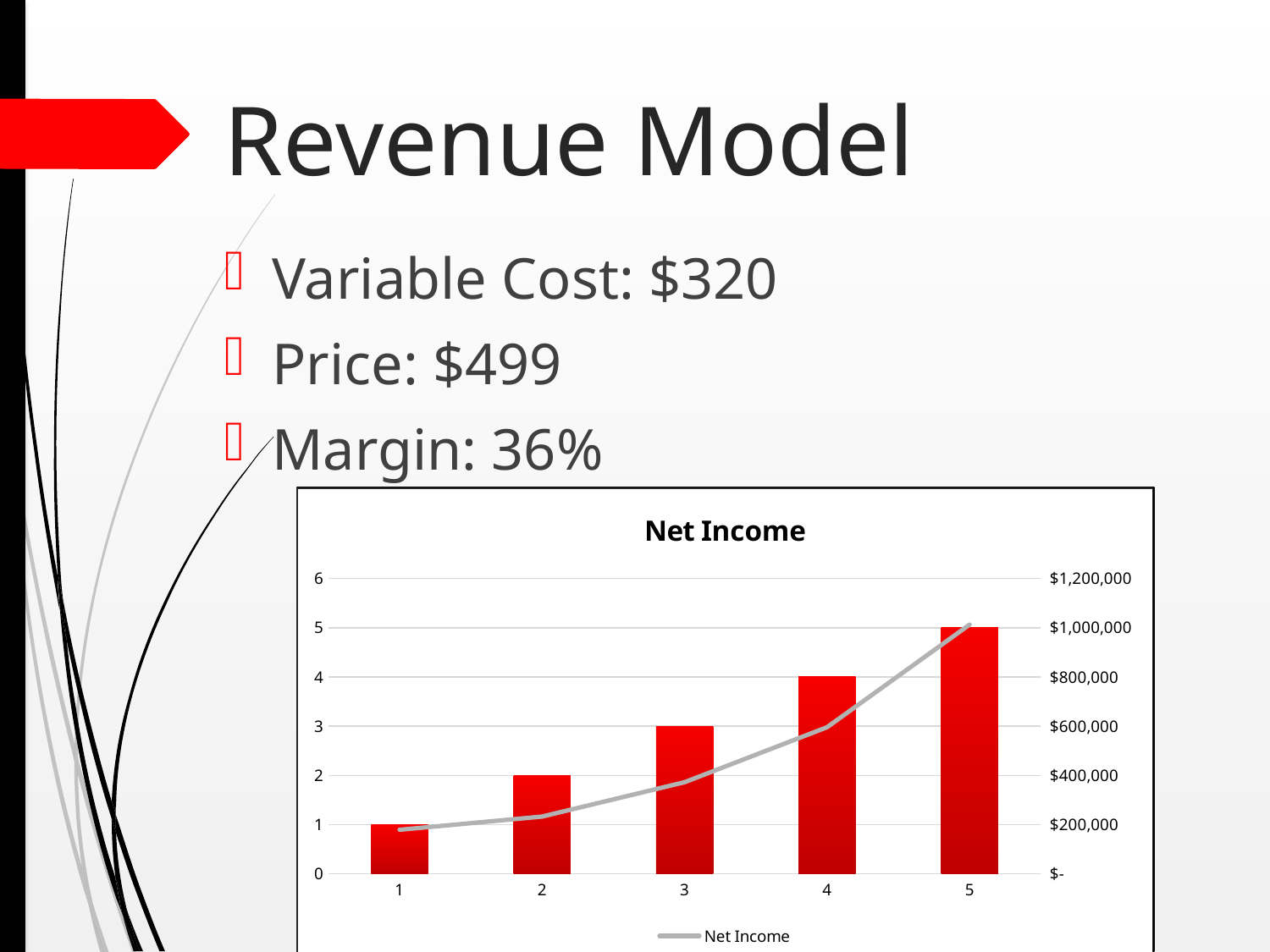
Which category has the tallest bar? 5 What is the bar value for category 3 on the left axis? 3 How many categories are shown on the x axis of the chart? 5 What is the bar value for category 5 on the left axis? 5 What is the difference between the bar values for category 4 and category 2? 2 How many series does the chart's legend list? 1 Which category has the shortest bar? 1 Do the bar values rise or fall from category 1 to category 5? rise What kind of chart is shown on the slide? bar chart with a line Which has the larger bar value, category 4 or category 2? 4 What is the title of the chart? Net Income